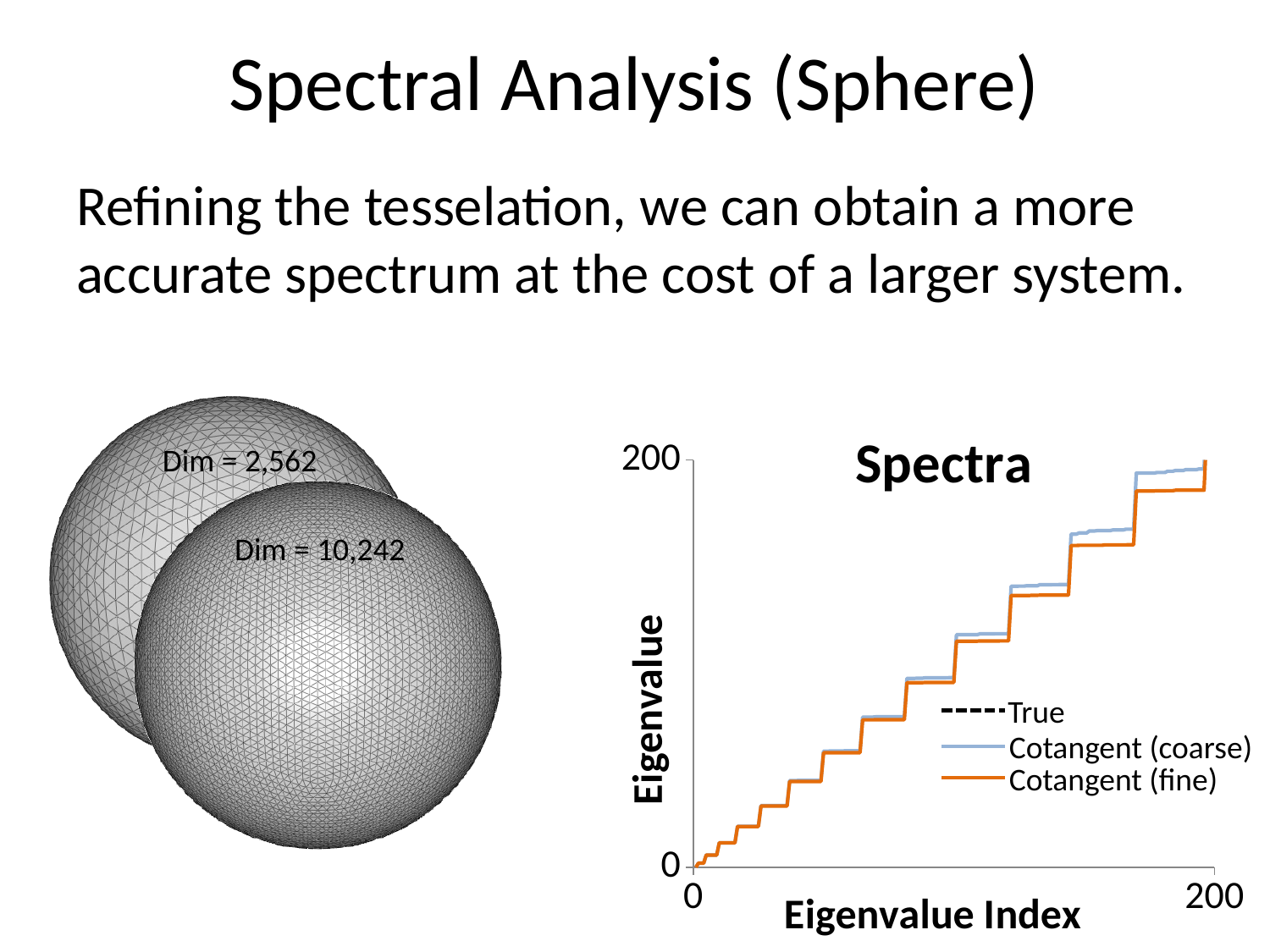
In the "Spectra" chart, is the value of Cotangent (fine) at eigenvalue index 200 greater or less than 100? greater In the "Spectra" chart, which series has the higher value at eigenvalue index 200, Cotangent (coarse) or Cotangent (fine)? Cotangent (coarse) What is the title of the chart on the slide? Spectra Which series in the "Spectra" chart is drawn in orange? Cotangent (fine) What kind of chart is the "Spectra" chart? line chart In the "Spectra" chart, do the eigenvalues rise or fall as the eigenvalue index increases? rise In the "Spectra" chart, is the value of Cotangent (coarse) at eigenvalue index 50 greater or less than 100? less How many series does the legend of the "Spectra" chart list? 3